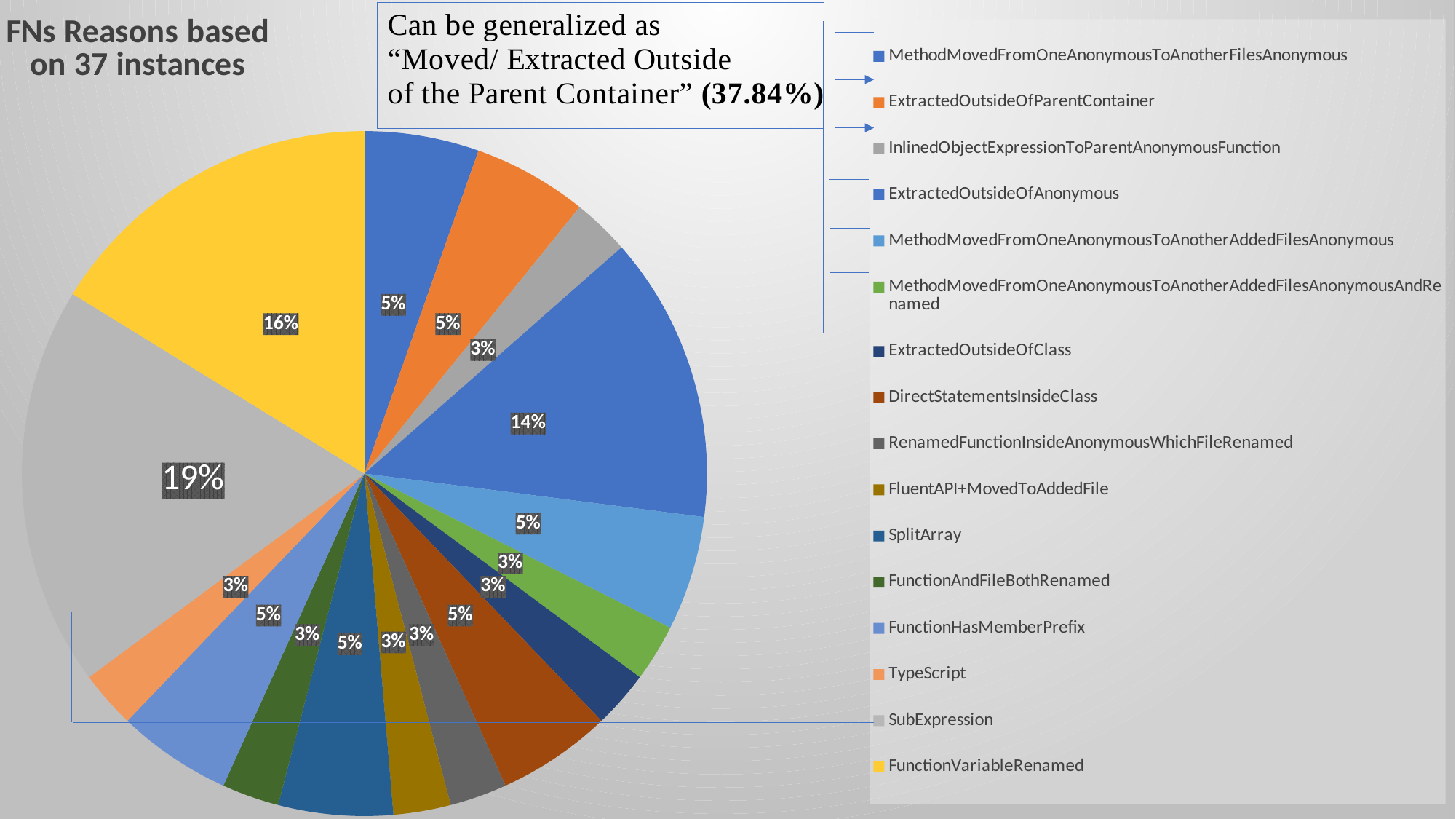
What share of the pie does FunctionVariableRenamed have? 16% What is the difference between the share for SubExpression and the share for ExtractedOutsideOfAnonymous? 5% What share of the pie does SplitArray have? 5% What kind of chart is shown on the slide? pie chart Which is larger, the share for SubExpression or the share for FunctionVariableRenamed? SubExpression What percentage does the text box say the 'Moved/ Extracted Outside of the Parent Container' generalization accounts for? 37.84% What share of the pie does ExtractedOutsideOfAnonymous have? 14% Which category has the largest share of the pie? SubExpression How many categories does the legend list? 16 What is the title of the chart? FNs Reasons based on 37 instances